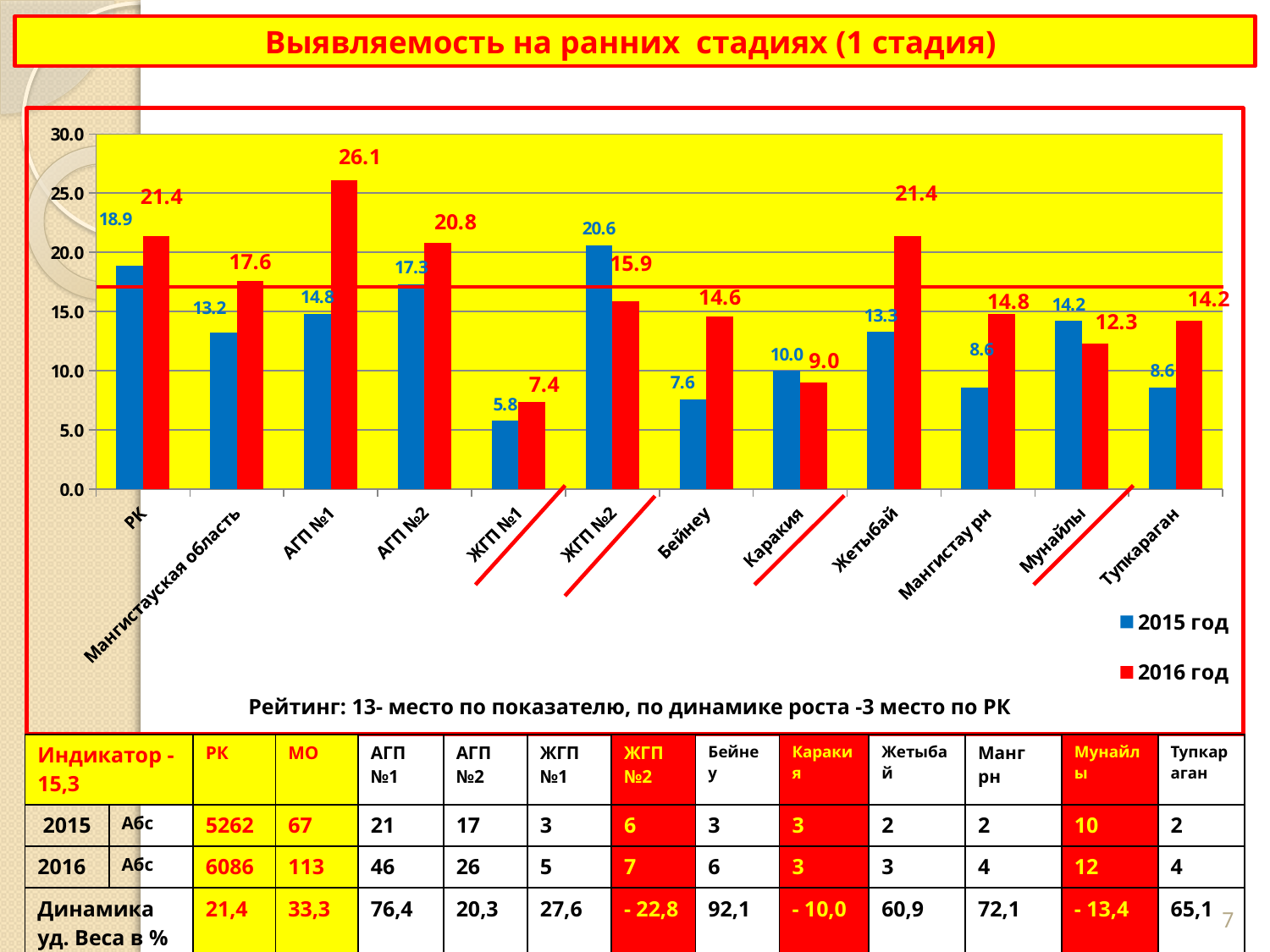
Is the 2016 год value for Мангистауская область greater or less than 15.0? greater How many categories are shown on the x axis of the chart? 12 What is the 2015 год value for ЖГП №2? 20.6 Which is larger for Каракия: the 2015 год value or the 2016 год value? 2015 год What is the 2016 год value for АГП №1? 26.1 What is the title of the slide's chart? Выявляемость на ранних стадиях (1 стадия) What is the difference between the 2016 год and 2015 год values for Жетыбай? 8.1 What is the 2016 год value for Бейнеу? 14.6 Which category has the highest 2016 год value? АГП №1 Which category has the lowest 2015 год value? ЖГП №1 What type of chart is shown on the slide? bar chart How many series does the chart legend list? 2